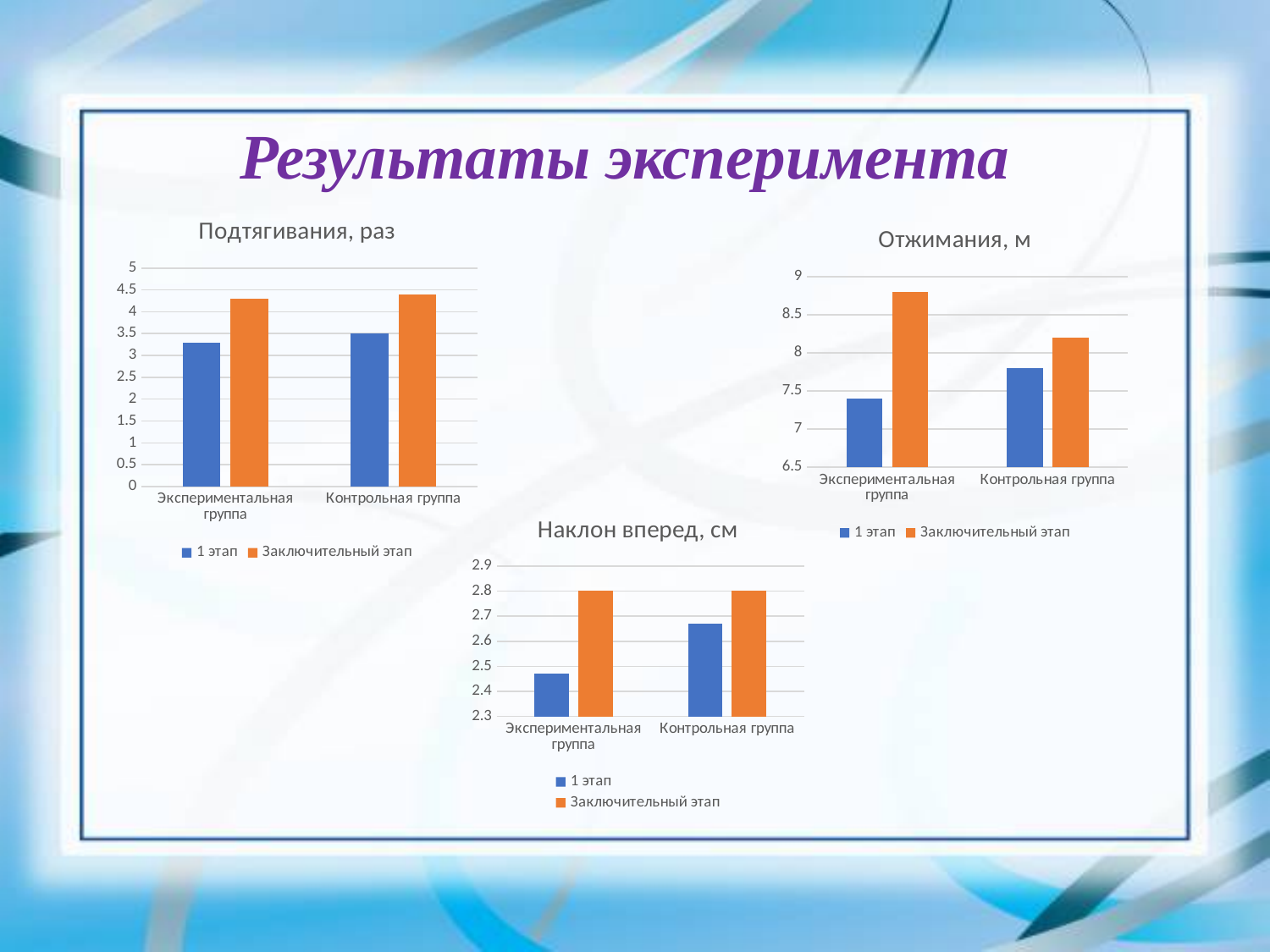
How many categories are shown on the x axis of the "Наклон вперед, см" chart? 2 In the "Подтягивания, раз" chart, is the value for 1 этап in Экспериментальная группа greater or less than 3.5? less What is the title of the chart in the top right of the slide? Отжимания, м In the "Наклон вперед, см" chart, is the value for 1 этап in Экспериментальная группа greater or less than 2.5? less In the "Отжимания, м" chart, which group has the highest Заключительный этап value? Экспериментальная группа In the "Отжимания, м" chart, is the value for 1 этап in Контрольная группа greater or less than 8? less In the "Отжимания, м" chart, which bar is the lowest? 1 этап, Экспериментальная группа What kind of chart is the "Подтягивания, раз" chart? bar chart How many series does the legend of the "Отжимания, м" chart list? 2 In the "Наклон вперед, см" chart, what is the value for Заключительный этап in Контрольная группа? 2.8 In the "Наклон вперед, см" chart, which is larger for 1 этап: Экспериментальная группа or Контрольная группа? Контрольная группа